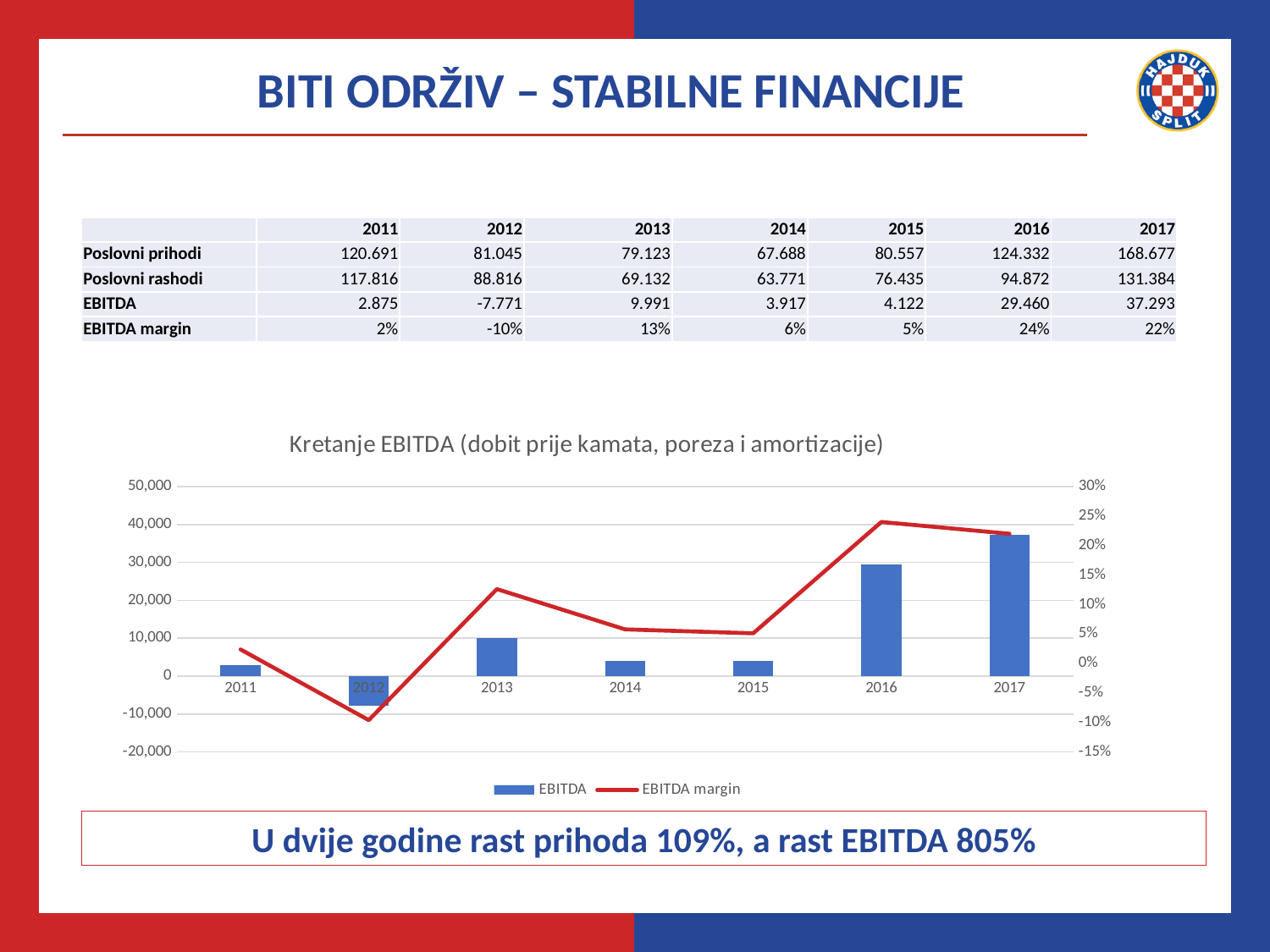
How many years are shown on the x axis of the chart? 7 Which year has the lowest EBITDA margin on the line? 2012 Does the EBITDA bar rise or fall from 2015 to 2017? rise What is the title of the chart? Kretanje EBITDA (dobit prije kamata, poreza i amortizacije) Which year has the highest EBITDA bar in the chart? 2017 Is the EBITDA margin for 2017 greater or less than 20%? greater What kind of chart is shown on the slide? A bar chart combined with a line Which year has the highest EBITDA margin on the line? 2016 Which year has the larger EBITDA bar, 2013 or 2014? 2013 Is the EBITDA bar for 2016 greater or less than 20,000? greater How many series does the chart legend list? 2 Which year has the lowest EBITDA bar in the chart? 2012